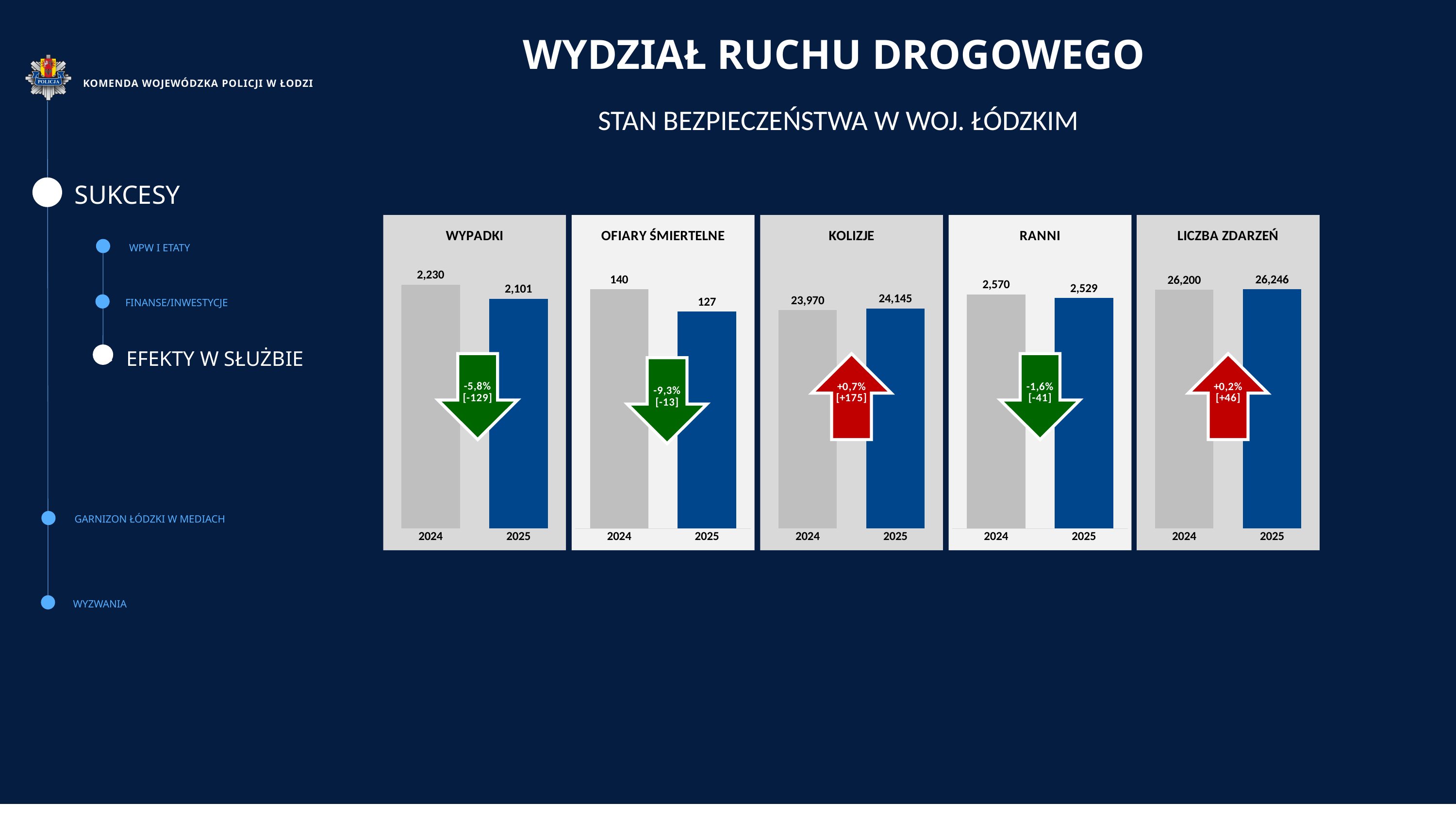
In the WYPADKI chart, what is the value for 2025? 2,101 In the RANNI chart, what is the value for 2025? 2,529 In the KOLIZJE chart, which year has the higher value, 2024 or 2025? 2025 In the WYPADKI chart, do the values rise or fall from 2024 to 2025? fall What kind of chart is the LICZBA ZDARZEŃ chart? bar chart In the RANNI chart, which year has the lower value? 2025 In the OFIARY ŚMIERTELNE chart, what is the difference between the 2024 and 2025 values? 13 In the LICZBA ZDARZEŃ chart, what is the value for 2025? 26,246 How many bars does the RANNI chart show? 2 In the OFIARY ŚMIERTELNE chart, what is the value for 2025? 127 In the WYPADKI chart, what is the value for 2024? 2,230 In the KOLIZJE chart, what is the value for 2024? 23,970